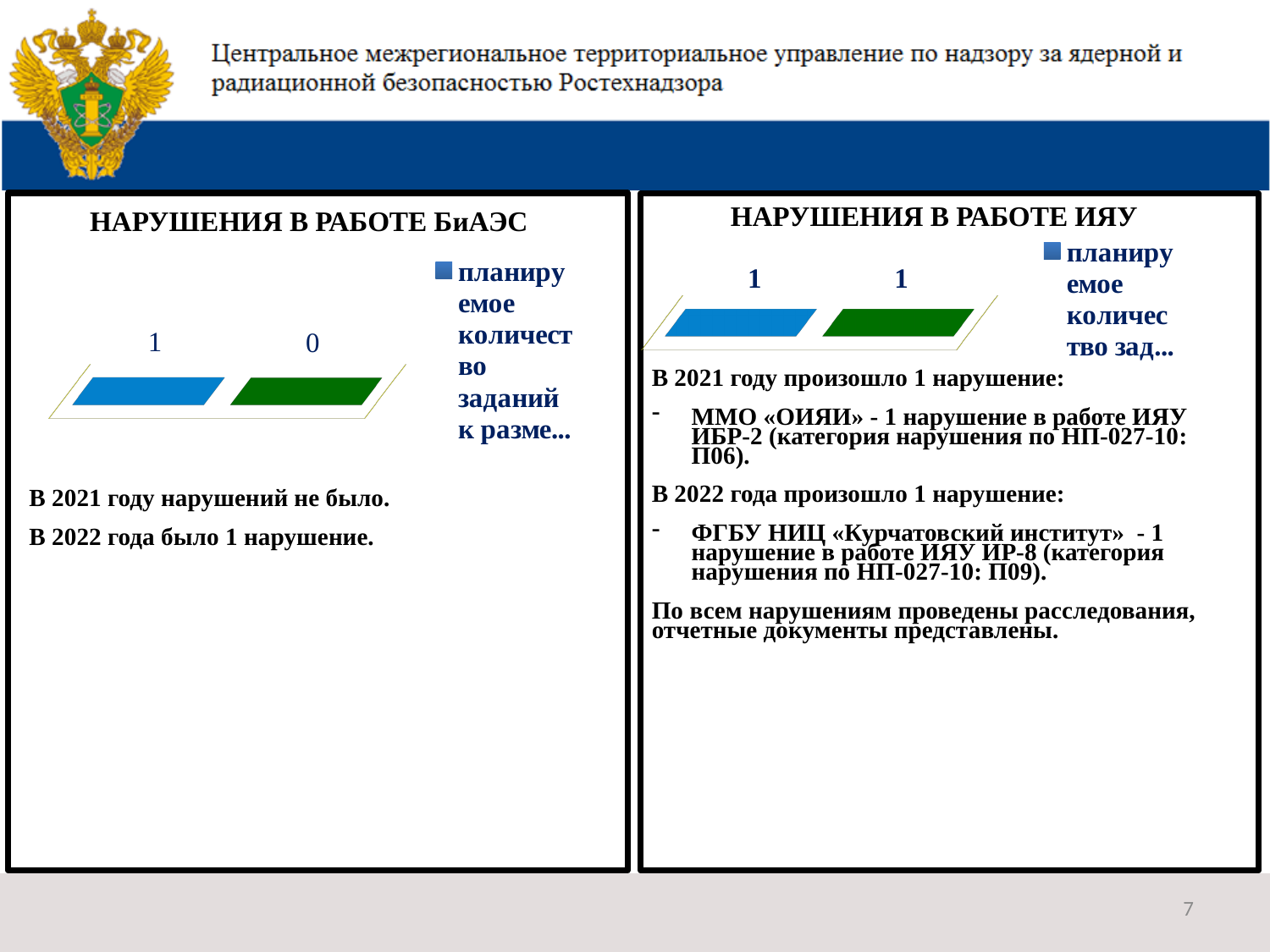
What is the title of the chart on the left side of the slide? НАРУШЕНИЯ В РАБОТЕ БиАЭС What kind of chart is shown under the title "НАРУШЕНИЯ В РАБОТЕ БиАЭС" on the left? bar chart In the left chart "НАРУШЕНИЯ В РАБОТЕ БиАЭС", which bar has the higher value, the blue one or the green one? the blue one In the left chart "НАРУШЕНИЯ В РАБОТЕ БиАЭС", what value is labelled on the blue (first) bar? 1 How many bars are plotted in the right chart "НАРУШЕНИЯ В РАБОТЕ ИЯУ"? 2 In the left chart "НАРУШЕНИЯ В РАБОТЕ БиАЭС", what is the difference between the blue bar's value and the green bar's value? 1 In the left chart "НАРУШЕНИЯ В РАБОТЕ БиАЭС", what value is labelled on the green (second) bar? 0 How many bars are plotted in the left chart "НАРУШЕНИЯ В РАБОТЕ БиАЭС"? 2 In the right chart "НАРУШЕНИЯ В РАБОТЕ ИЯУ", what value is labelled on the blue (first) bar? 1 How many series does the legend of the right chart "НАРУШЕНИЯ В РАБОТЕ ИЯУ" list? 1 In the right chart "НАРУШЕНИЯ В РАБОТЕ ИЯУ", what colour is the second bar? green In the right chart "НАРУШЕНИЯ В РАБОТЕ ИЯУ", what value is labelled on the green (second) bar? 1